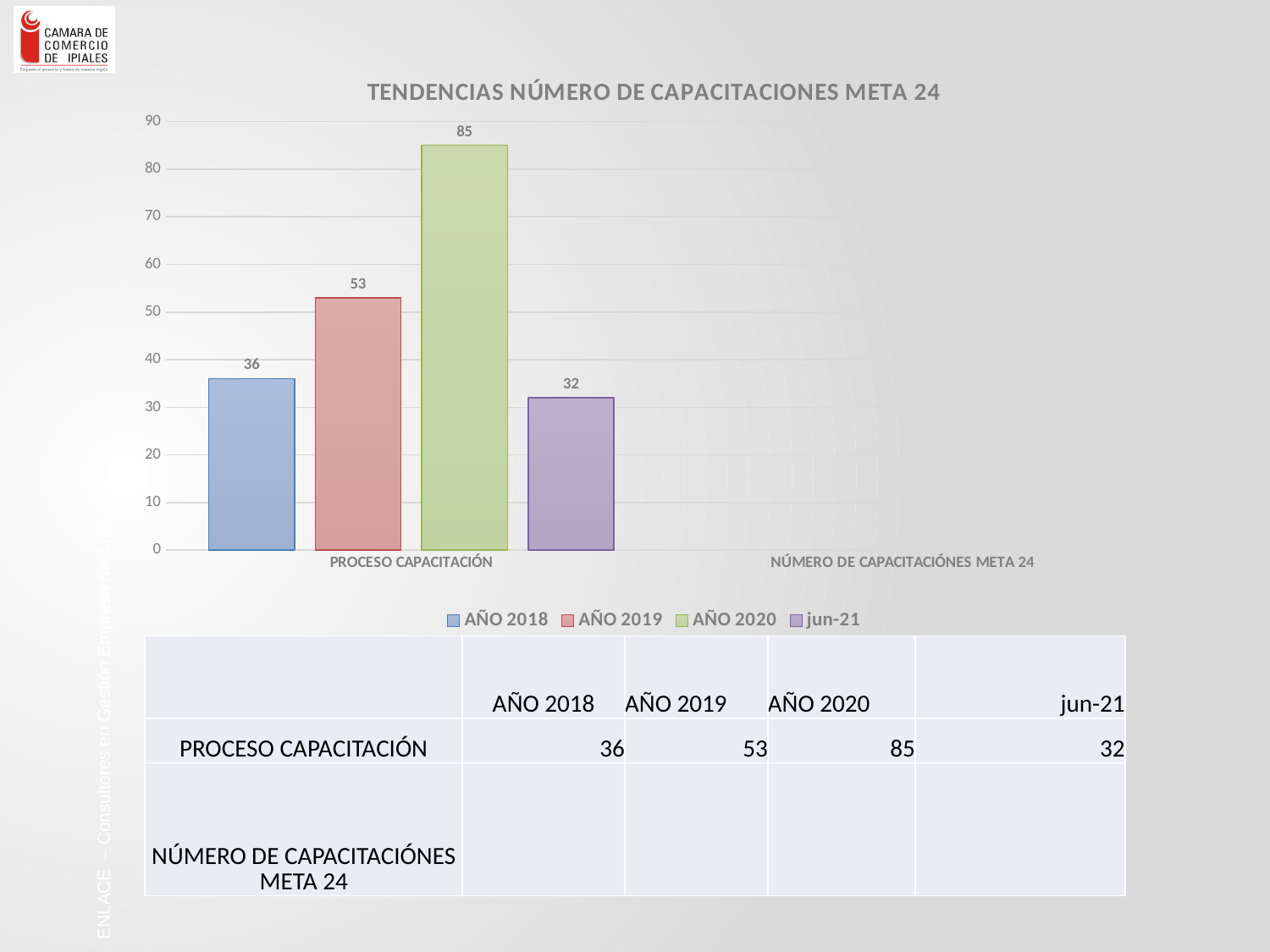
What is the difference between the AÑO 2020 and AÑO 2019 values for PROCESO CAPACITACIÓN? 32 Which series has the lowest value for PROCESO CAPACITACIÓN? jun-21 What is the value for AÑO 2018 in the PROCESO CAPACITACIÓN category? 36 What is the value for jun-21 in the PROCESO CAPACITACIÓN category? 32 Which is larger for PROCESO CAPACITACIÓN, AÑO 2019 or AÑO 2018? AÑO 2019 What is the title of the chart? TENDENCIAS NÚMERO DE CAPACITACIONES META 24 Which series has the highest value for PROCESO CAPACITACIÓN? AÑO 2020 What colour is the bar for AÑO 2020? green How many series does the legend list? 4 Is the value for AÑO 2019 in PROCESO CAPACITACIÓN greater or less than 50? greater What is the value for AÑO 2020 in the PROCESO CAPACITACIÓN category? 85 What kind of chart is shown on the slide? bar chart